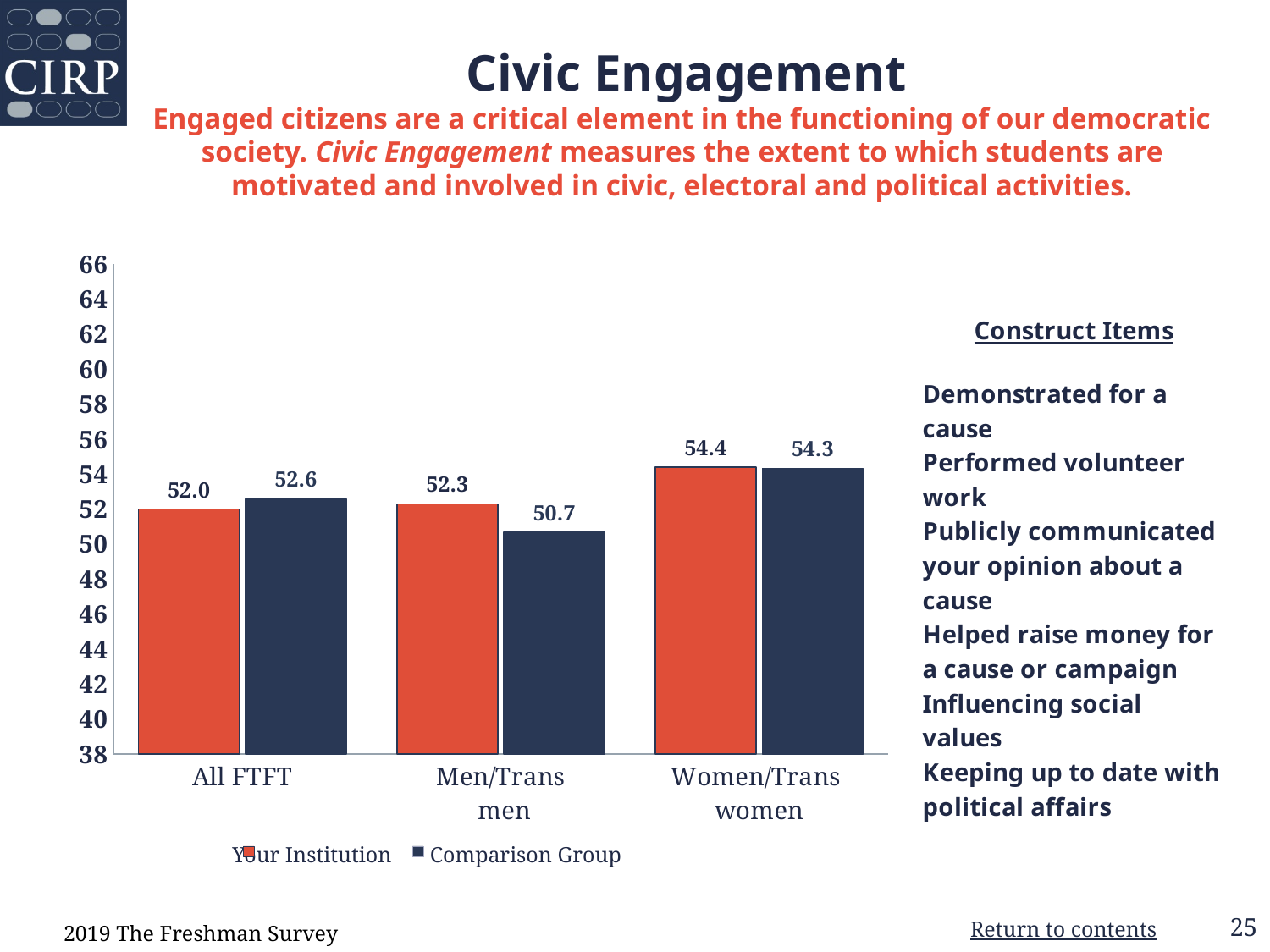
How many series does the legend list? 2 How many categories are shown on the x axis? 3 What is the difference between the Your Institution and Comparison Group values for Men/Trans men? 1.6 For All FTFT, which is larger: Your Institution or Comparison Group? Comparison Group What kind of chart is shown on the slide? Bar chart What colour are the Your Institution bars? Orange-red Which category has the highest Your Institution value? Women/Trans women What is the Your Institution value for Women/Trans women? 54.4 What is the Comparison Group value for Men/Trans men? 50.7 What is the Civic Engagement value for Your Institution in the All FTFT category? 52.0 What is the Comparison Group value for All FTFT? 52.6 Which category has the lowest Comparison Group value? Men/Trans men